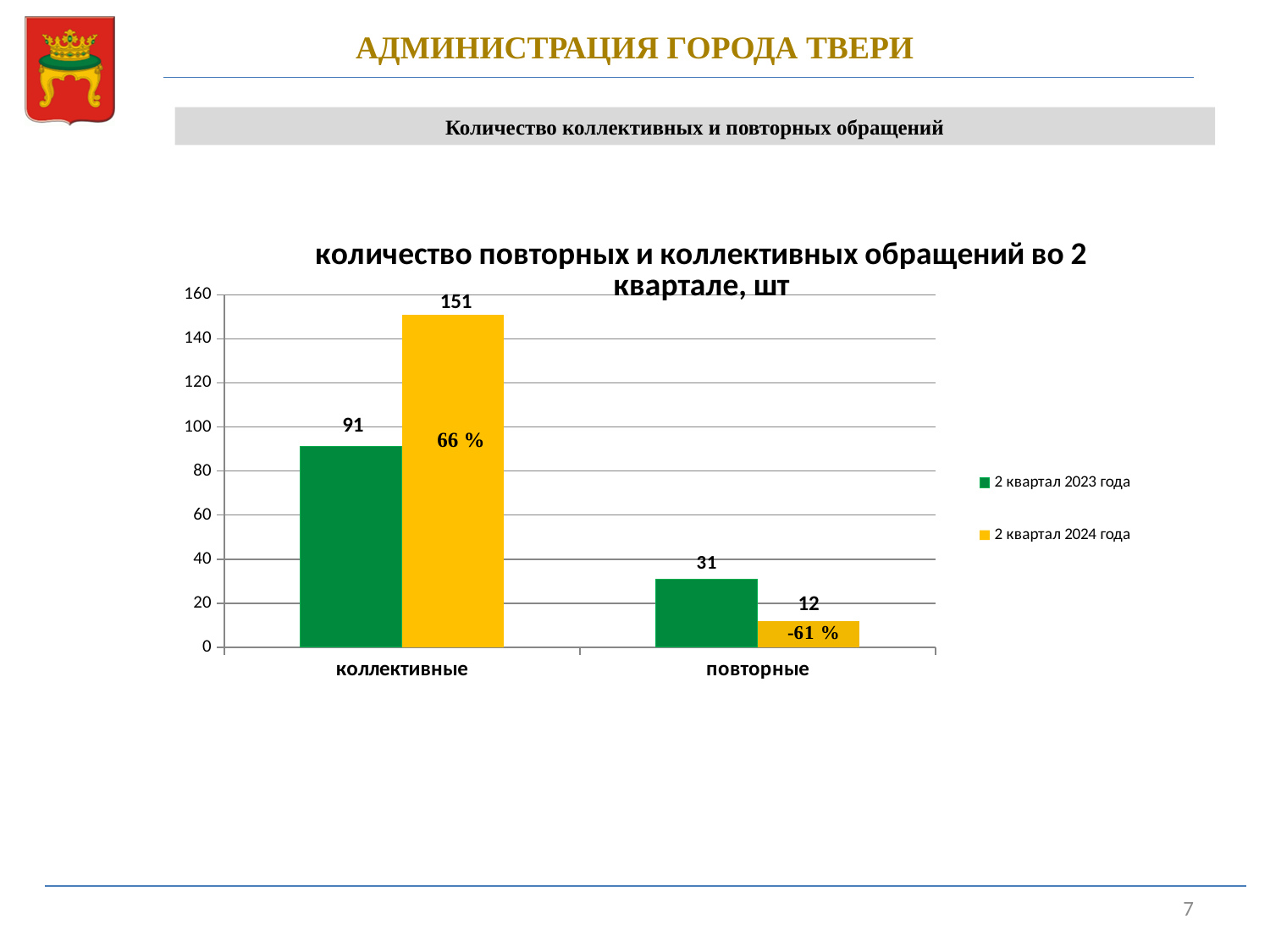
What kind of chart is shown on the slide? bar chart How many series does the legend list? 2 What is the difference between the 2 квартал 2023 года and 2 квартал 2024 года values for повторные? 19 Which is larger for повторные: 2 квартал 2023 года or 2 квартал 2024 года? 2 квартал 2023 года What is the difference between the 2 квартал 2024 года and 2 квартал 2023 года values for коллективные? 60 Which category has the highest value in 2 квартал 2024 года? коллективные How many categories are shown on the x axis? 2 Which category has the lowest value in 2 квартал 2023 года? повторные What is the value for повторные in 2 квартал 2024 года? 12 What is the value for повторные in 2 квартал 2023 года? 31 What is the value for коллективные in 2 квартал 2024 года? 151 What is the value for коллективные in 2 квартал 2023 года? 91